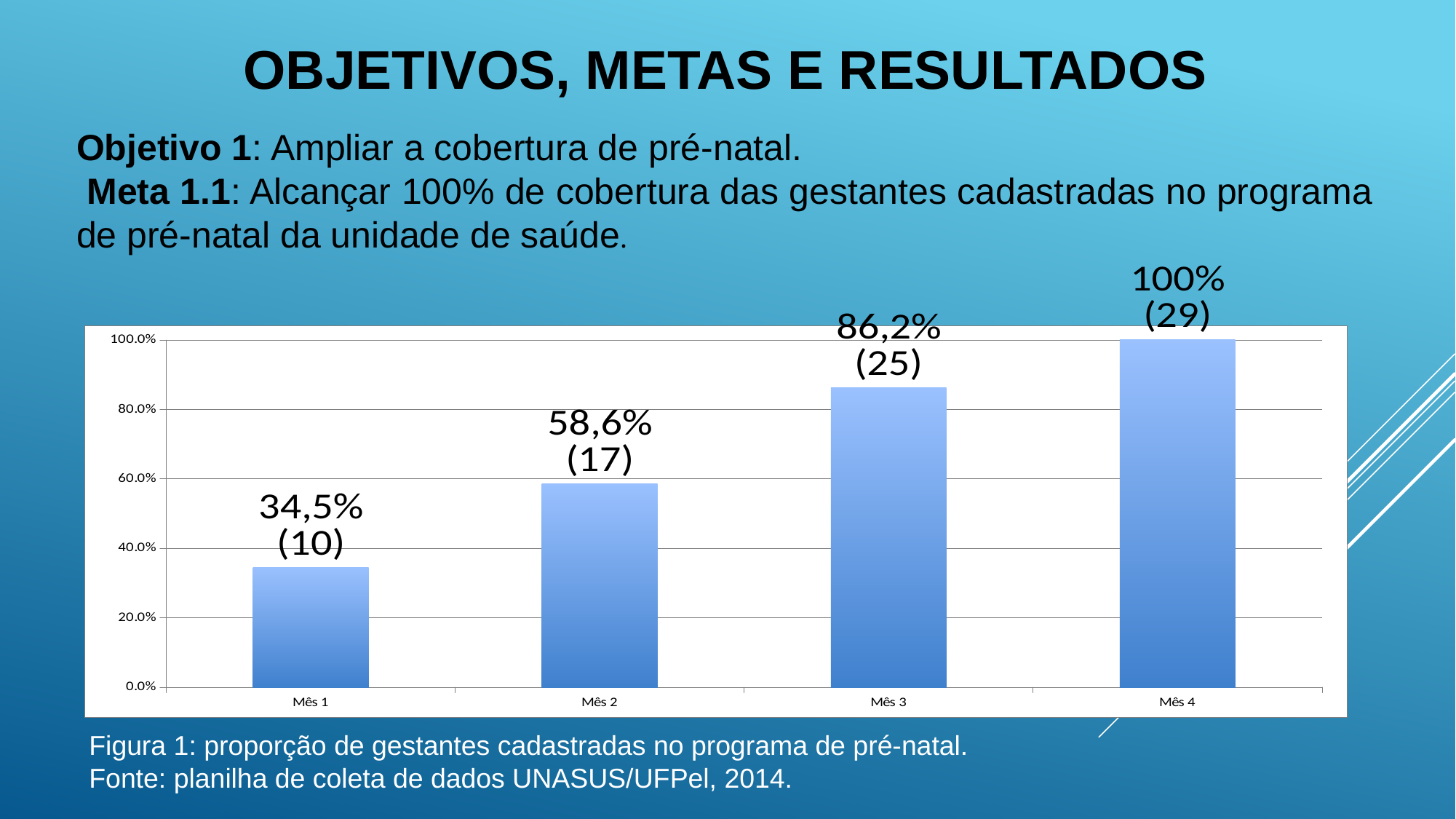
What is the difference in the number of pregnant women (in parentheses) between Mês 4 and Mês 1? 19 Is the value for Mês 2 greater or less than 40.0%? greater What kind of chart is shown on the slide? bar chart What is the value shown for Mês 3? 86,2% Do the values rise or fall from Mês 1 to Mês 4? rise Which month has the lowest value? Mês 1 Which month has the highest value? Mês 4 How many months are shown on the x axis? 4 What is the caption given for the figure below the chart? Figura 1: proporção de gestantes cadastradas no programa de pré-natal. What is the value shown for Mês 1? 34,5% How many pregnant women does the label for Mês 2 show in parentheses? 17 Which is larger, the value for Mês 2 or the value for Mês 3? Mês 3